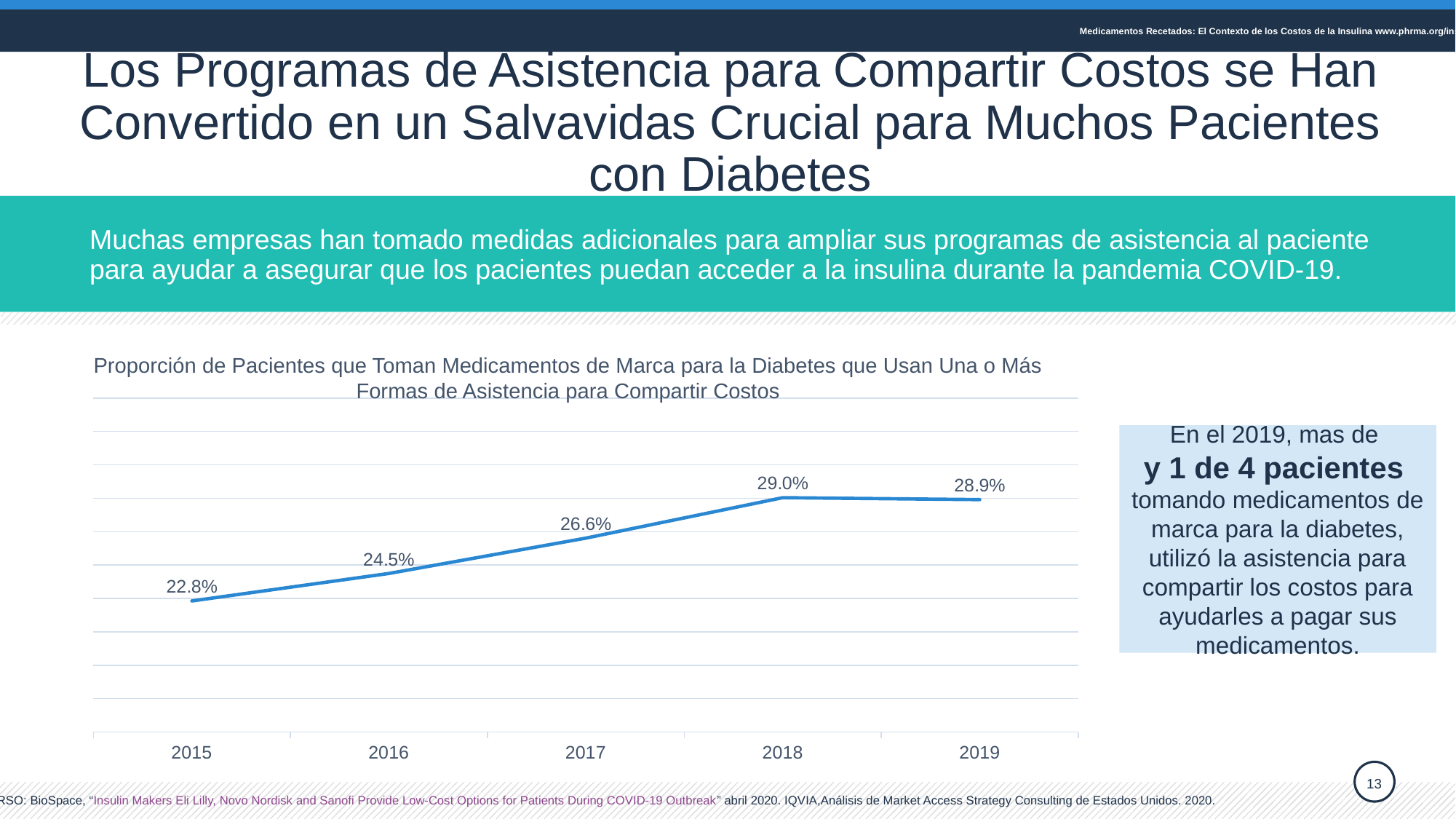
What was the proportion of patients using cost-sharing assistance in 2015? 22.8% What value is shown for 2019? 28.9% How many years are plotted on the chart? 5 What kind of chart is shown on the slide? Line chart Which year has the highest value on the chart? 2018 Which year has a larger value, 2016 or 2017? 2017 What is the difference between the 2018 value and the 2015 value? 6.2% What is the difference between the 2016 value and the 2017 value? 2.1% Does the value rise or fall from 2015 to 2018? Rise What is the title of the chart? Proporción de Pacientes que Toman Medicamentos de Marca para la Diabetes que Usan Una o Más Formas de Asistencia para Compartir Costos Which year has the lowest value on the chart? 2015 What value is shown for 2017? 26.6%